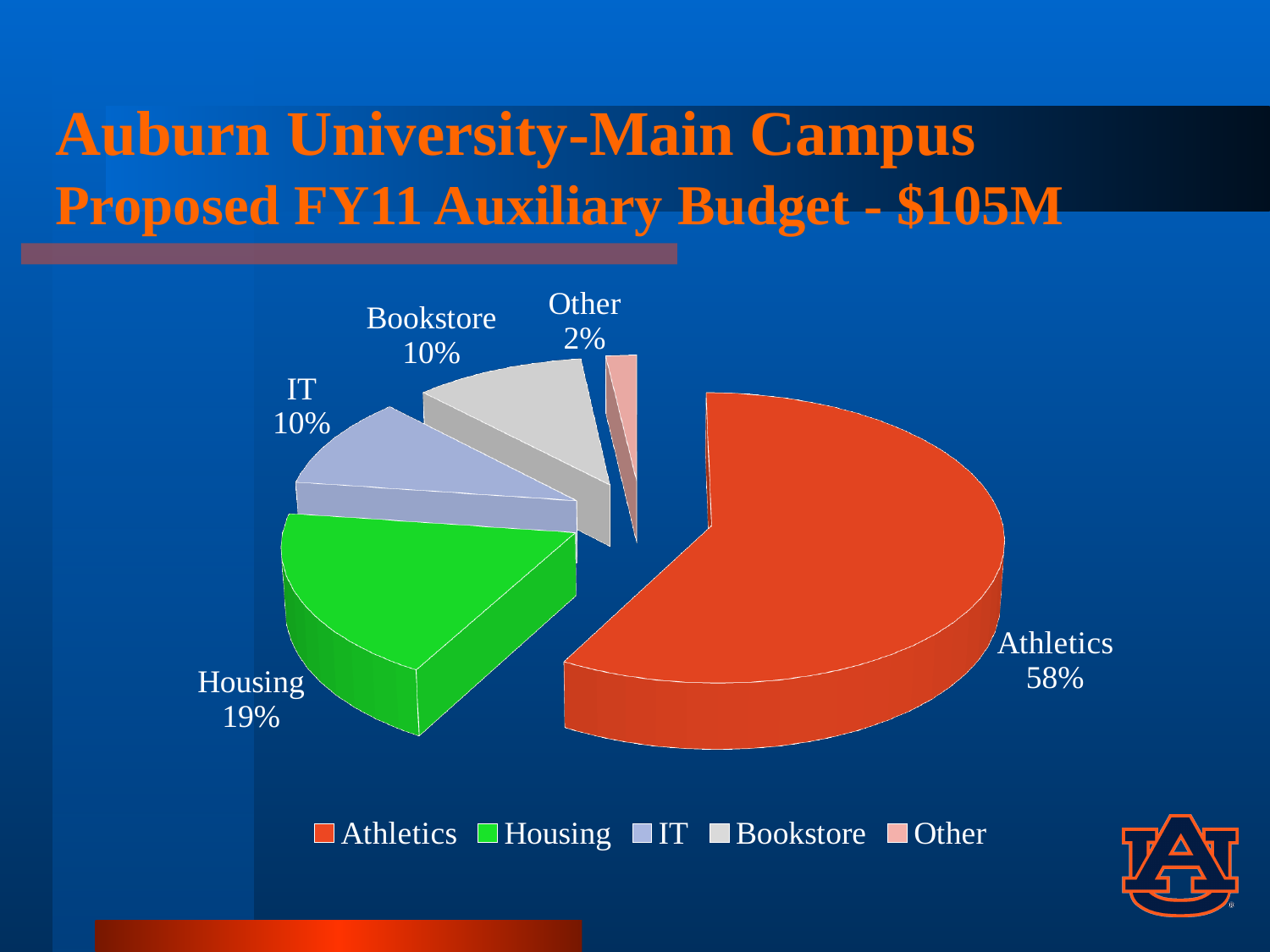
What percentage of the pie is Housing? 19% Which category has the largest share of the auxiliary budget? Athletics What share does the Bookstore slice represent? 10% Which category has the smallest share of the auxiliary budget? Other How many percentage points larger is the Athletics share than the Housing share? 39 What is the difference in percentage points between Housing and IT? 9 What total budget amount is stated in the slide title? $105M What percentage is shown for the Other slice? 2% What share of the proposed FY11 auxiliary budget goes to Athletics? 58% What type of chart is shown on the slide? Pie chart Which is larger, the Housing share or the Bookstore share? Housing How many categories are shown in the pie chart? 5